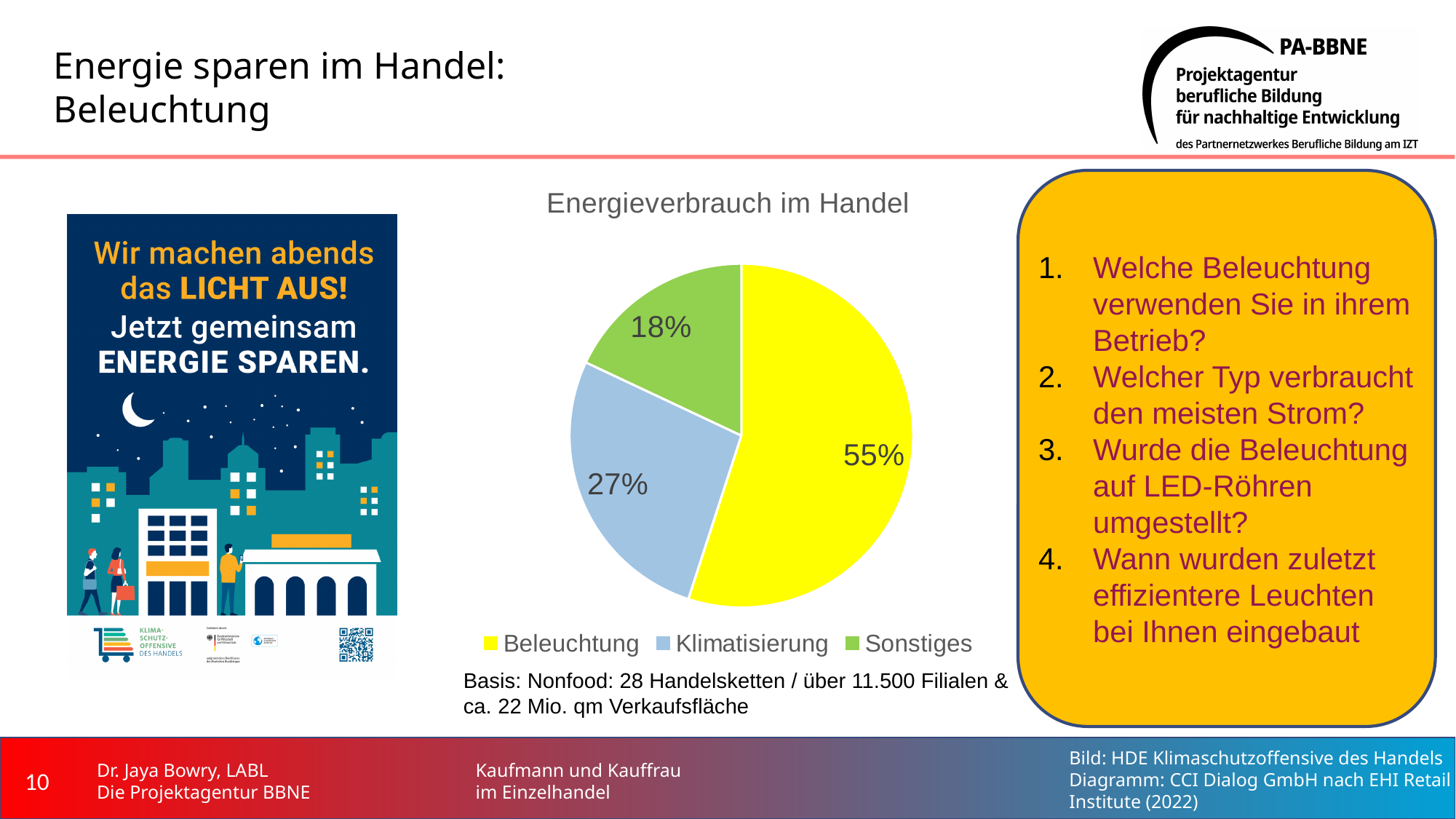
What is the title of the pie chart? Energieverbrauch im Handel What share of the pie does Klimatisierung account for? 27% What share of the pie does Sonstiges account for? 18% Which is larger, the share for Klimatisierung or the share for Sonstiges? Klimatisierung What kind of chart is shown under the title "Energieverbrauch im Handel"? pie chart Which category has the largest share of the pie? Beleuchtung What is the difference in percentage points between Klimatisierung and Sonstiges? 9 Which colour represents Beleuchtung in the pie chart? yellow What share of the pie does Beleuchtung account for? 55% How many categories does the pie chart show? 3 Which category has the smallest share of the pie? Sonstiges What is the difference in percentage points between Beleuchtung and Klimatisierung? 28